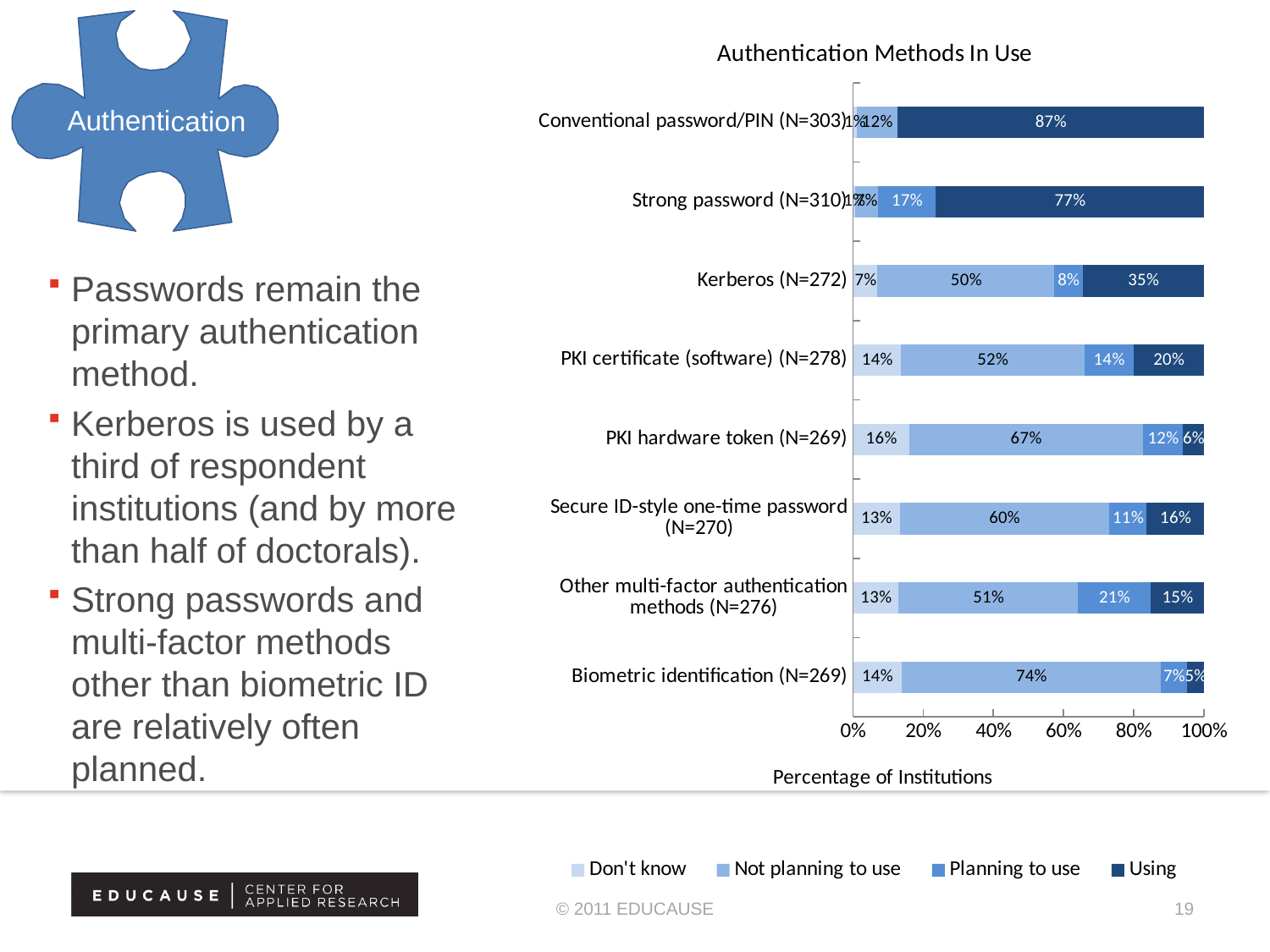
Which authentication method has the highest 'Not planning to use' percentage? Biometric identification (N=269) What is the difference in 'Using' percentage between Conventional password/PIN (87%) and Strong password (77%)? 10 percentage points How many series does the legend list? 4 What percentage of institutions are using Kerberos (N=272)? 35% What is the label on the horizontal axis of the chart? Percentage of Institutions What percentage of institutions are not planning to use Biometric identification (N=269)? 74% What is the 'Don't know' percentage for PKI hardware token (N=269)? 16% What kind of chart is shown on the slide? Stacked bar chart How many authentication methods (categories) are plotted in the chart? 8 Which authentication method has the highest 'Using' percentage? Conventional password/PIN (N=303) Which has a larger 'Planning to use' percentage: Other multi-factor authentication methods (N=276) or PKI certificate (software) (N=278)? Other multi-factor authentication methods (N=276) Which authentication method has the lowest 'Using' percentage? Biometric identification (N=269)